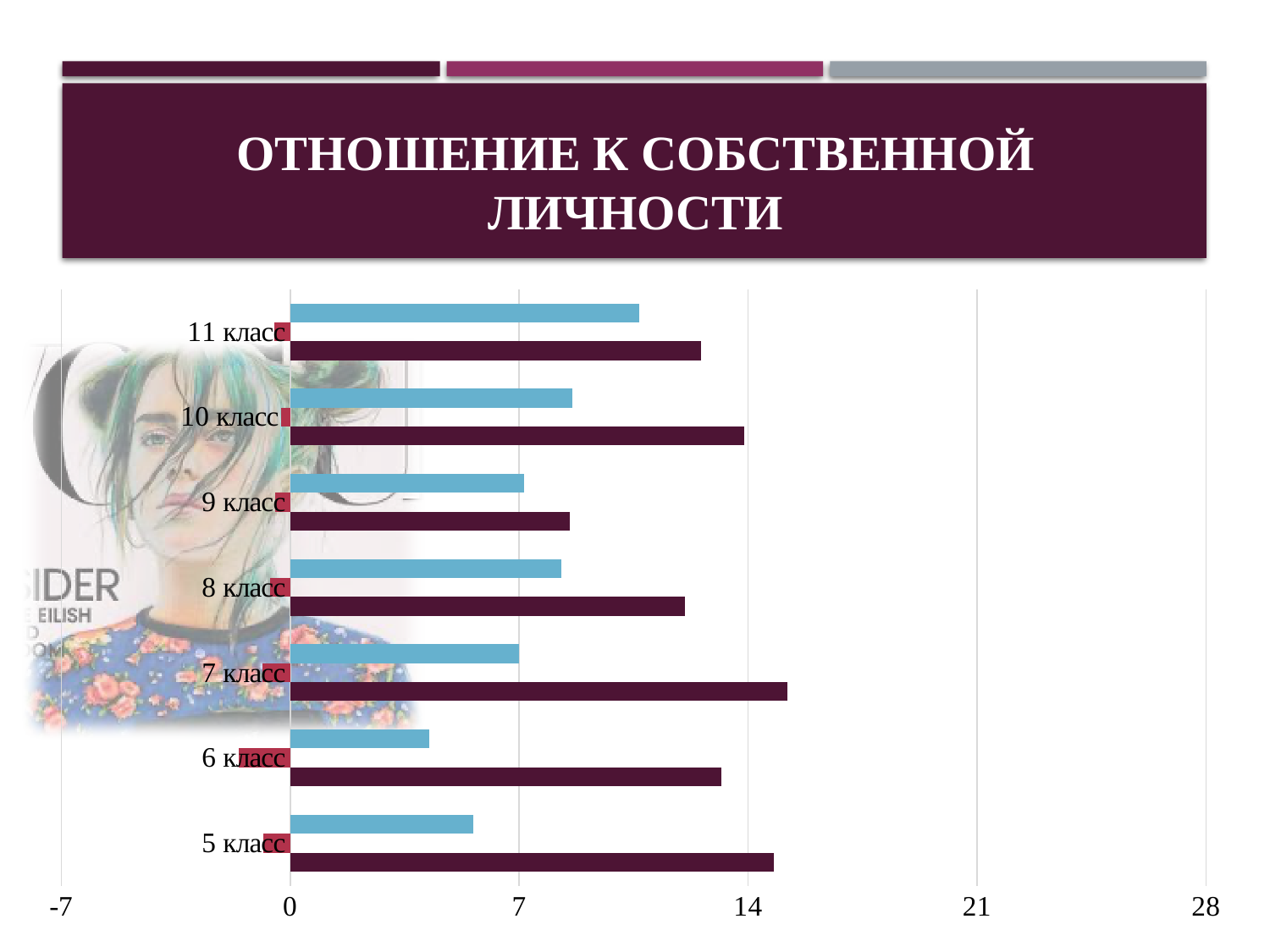
Is the light blue bar for 11 класс greater or less than 7? greater Which is longer, the dark purple bar for 7 класс or the dark purple bar for 9 класс? 7 класс What is the title of the slide with the chart? ОТНОШЕНИЕ К СОБСТВЕННОЙ ЛИЧНОСТИ Which class has the shortest dark purple bar? 9 класс Which class has the shortest light blue bar? 6 класс How many class categories are shown on the chart? 7 Which class has the longest light blue bar? 11 класс Is the dark purple bar for 9 класс greater or less than 14? less Which is longer, the light blue bar for 11 класс or the light blue bar for 5 класс? 11 класс Is the light blue bar for 6 класс greater or less than 7? less What kind of chart is shown on the slide? bar chart